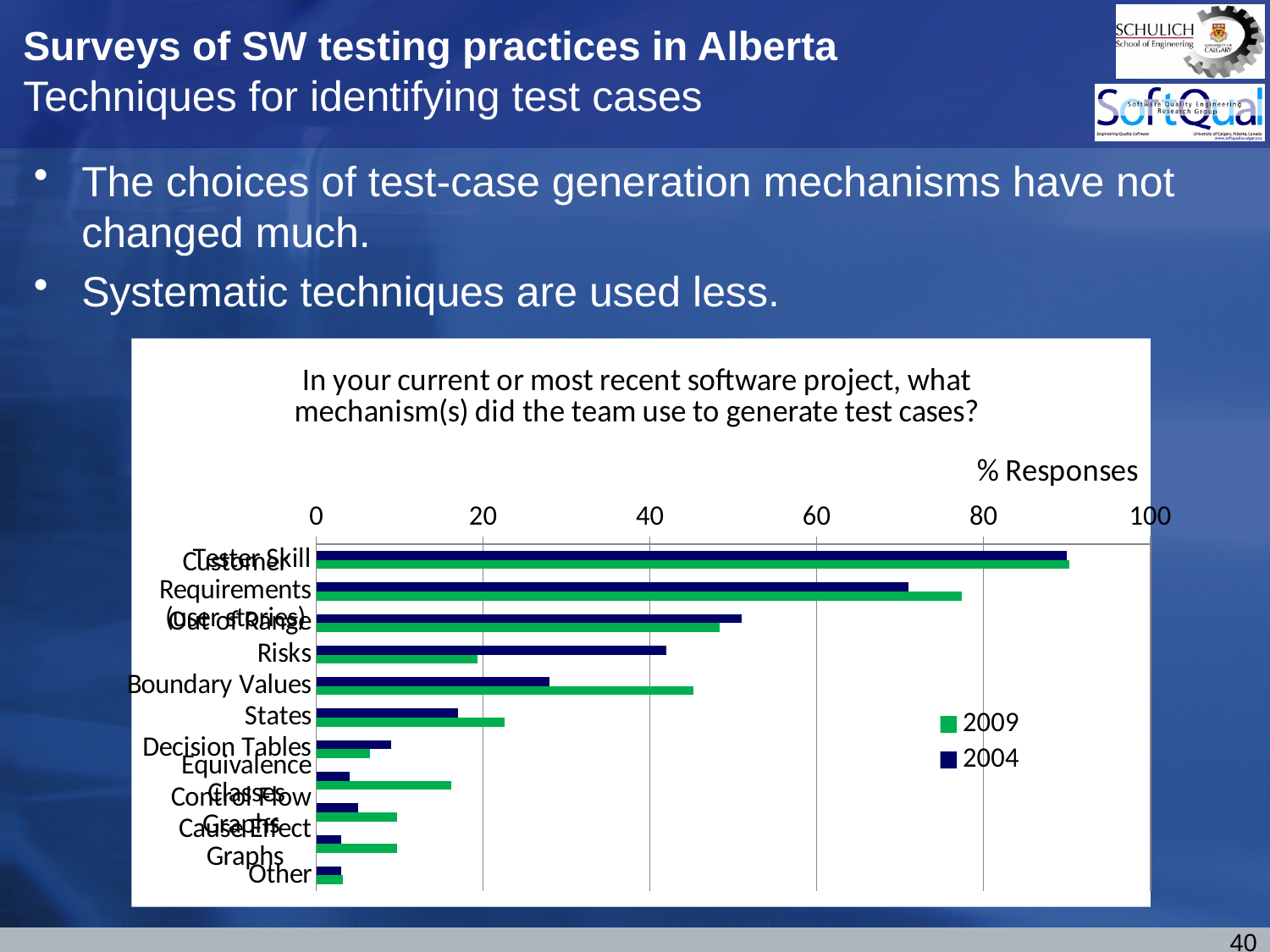
Is the 2009 value for Decision Tables greater or less than 20? less For Boundary Values, which year has the larger value, 2004 or 2009? 2009 Is the 2004 value for Boundary Values greater or less than 40? less Is the 2009 value for Risks greater or less than 40? less What kind of chart is shown on the slide? bar chart For Risks, which year has the larger value, 2004 or 2009? 2004 Which two years are listed in the chart's legend? 2009 and 2004 How many series does the chart's legend list? 2